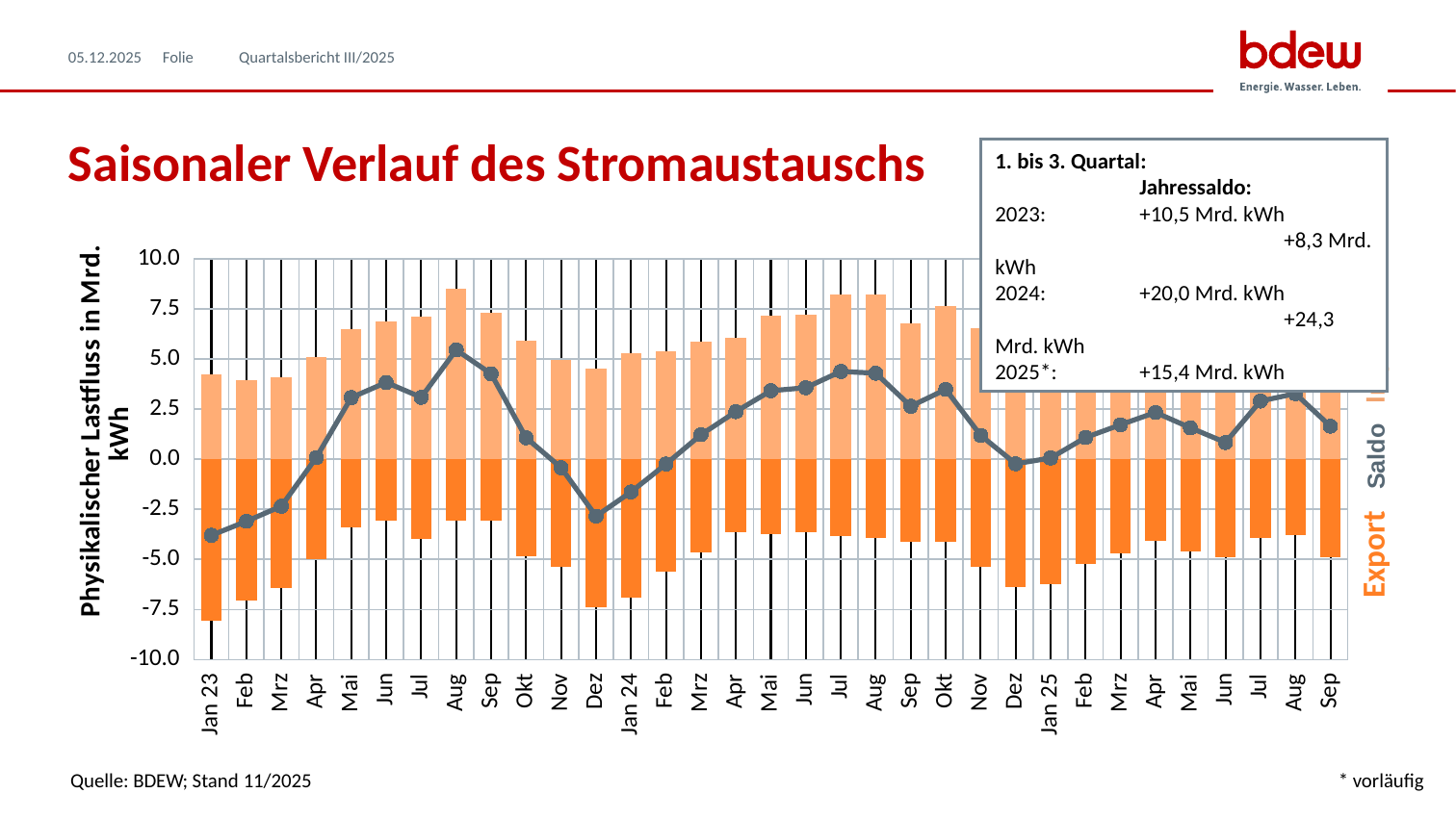
Is the Saldo value for Jan 24 greater or less than 0.0? less Does the Saldo line rise or fall from Jan 23 to Aug 23? rise Is the Saldo value for Aug 23 greater or less than 5.0? greater Which month has the highest Saldo value on the line? Aug 23 What is the title of the y axis of the chart? Physikalischer Lastfluss in Mrd. kWh Which month has the lowest Saldo value on the line? Jan 23 Which has the larger Saldo value, Jul 24 or Dez 24? Jul 24 Is the import bar for Aug 23 greater or less than 7.5? greater How many months are plotted along the x axis of the chart? 33 What kind of chart is shown on the slide? A combined bar and line chart Does the Saldo line rise or fall from Aug 23 to Dez 23? fall